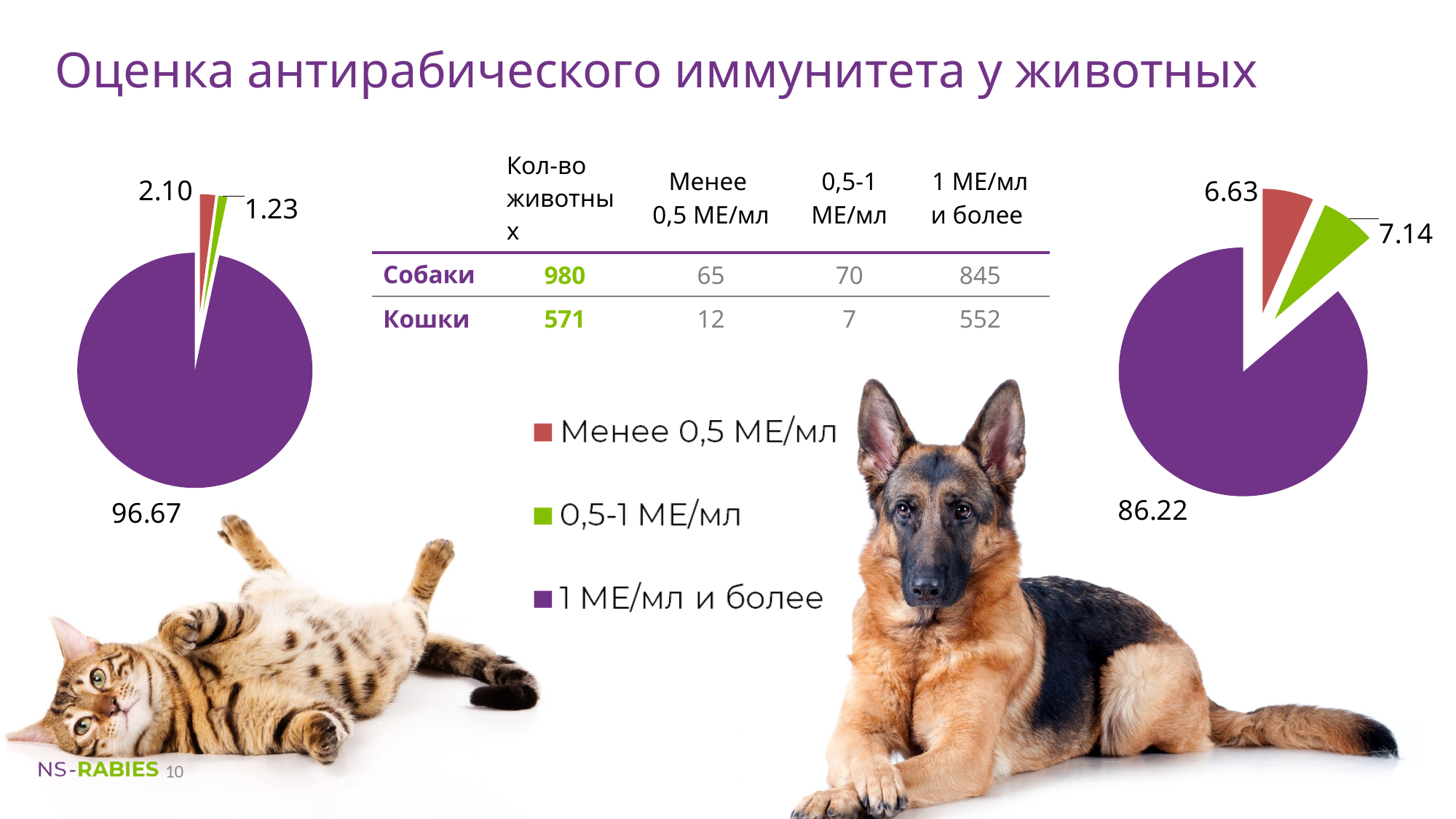
In the pie chart on the left of the slide, which is larger: the red slice (Менее 0,5 МЕ/мл) or the green slice (0,5-1 МЕ/мл)? Менее 0,5 МЕ/мл How many entries does the legend in the middle of the slide list? 3 In the pie chart on the right of the slide, which category has the smallest slice? Менее 0,5 МЕ/мл In the pie chart on the right of the slide, what is the value of the largest slice? 86.22 In the pie chart on the right of the slide, what value is shown for the green slice (0,5-1 МЕ/мл)? 7.14 In the pie chart on the left of the slide, which category has the smallest slice? 0,5-1 МЕ/мл In the pie chart on the left of the slide, what is the value of the largest slice? 96.67 What type of chart is shown on the right of the slide? Pie chart In the pie chart on the right of the slide, what is the difference between the green slice (7.14) and the red slice (6.63)? 0.51 How many slices does the pie chart on the left of the slide have? 3 In the pie chart on the right of the slide, which category has the largest slice? 1 МЕ/мл и более In the pie chart on the left of the slide, what value is shown for the red slice (Менее 0,5 МЕ/мл)? 2.10